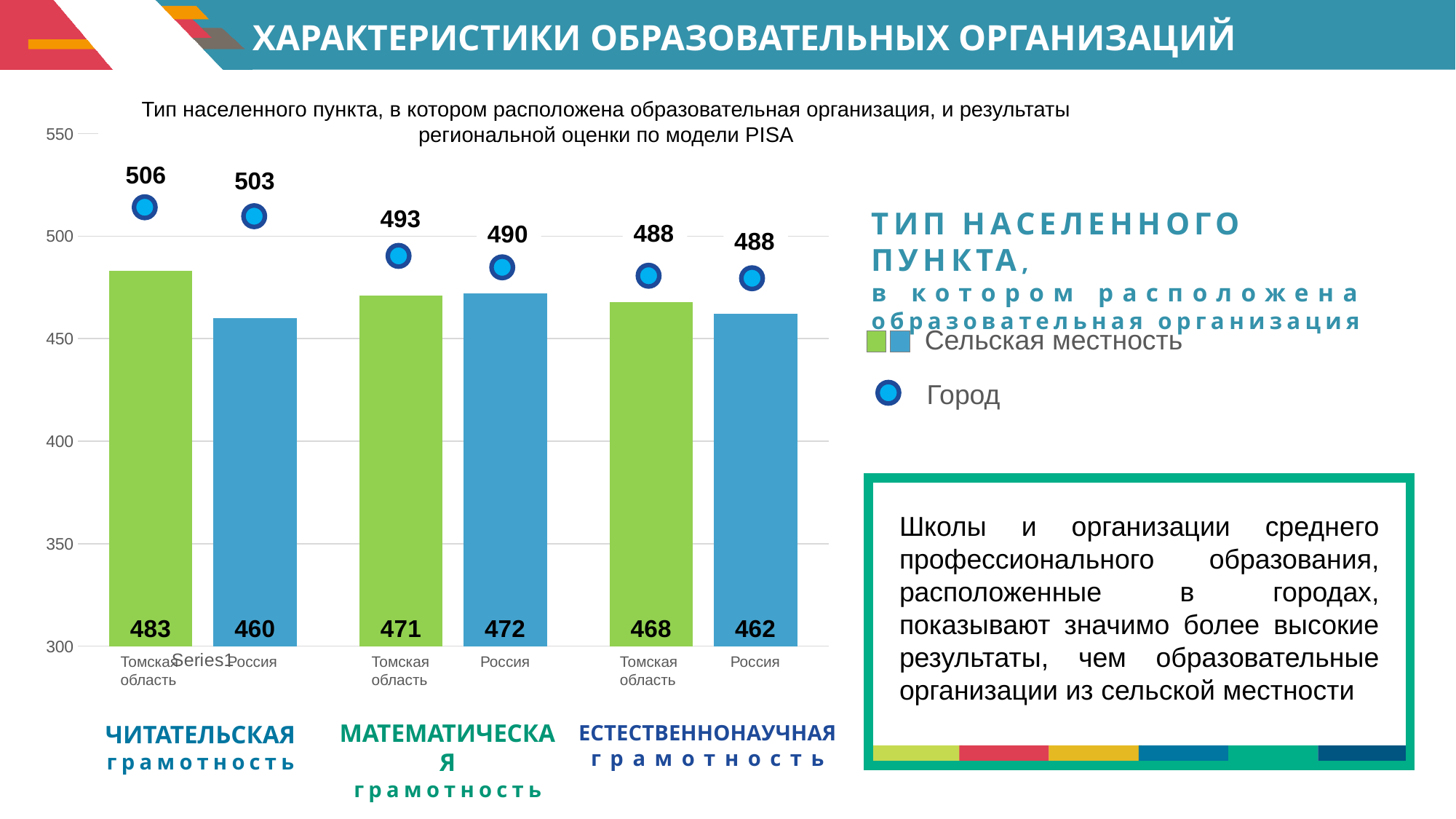
What is the city (Город) value for Россия in mathematical literacy (Математическая грамотность)? 490 What is the rural (Сельская местность) value for Томская область in reading literacy (Читательская грамотность)? 483 Which is larger in mathematical literacy: the rural value for Томская область or the rural value for Россия? Россия (472) What are the two legend entries of the chart? Сельская местность, Город Which bar has the highest rural (Сельская местность) value? Томская область, Читательская грамотность (483) What kind of chart is shown on the slide? Bar chart with point markers How many bars are plotted in the chart? 6 What is the rural (Сельская местность) value for Россия in science literacy (Естественнонаучная грамотность)? 462 What is the difference between the city (Город) and rural (Сельская местность) values for Томская область in reading literacy? 23 Which bar has the lowest rural (Сельская местность) value? Россия, Читательская грамотность (460) How many series does the legend list? 2 Is the city (Город) value for Томская область in reading literacy greater or less than 500? greater